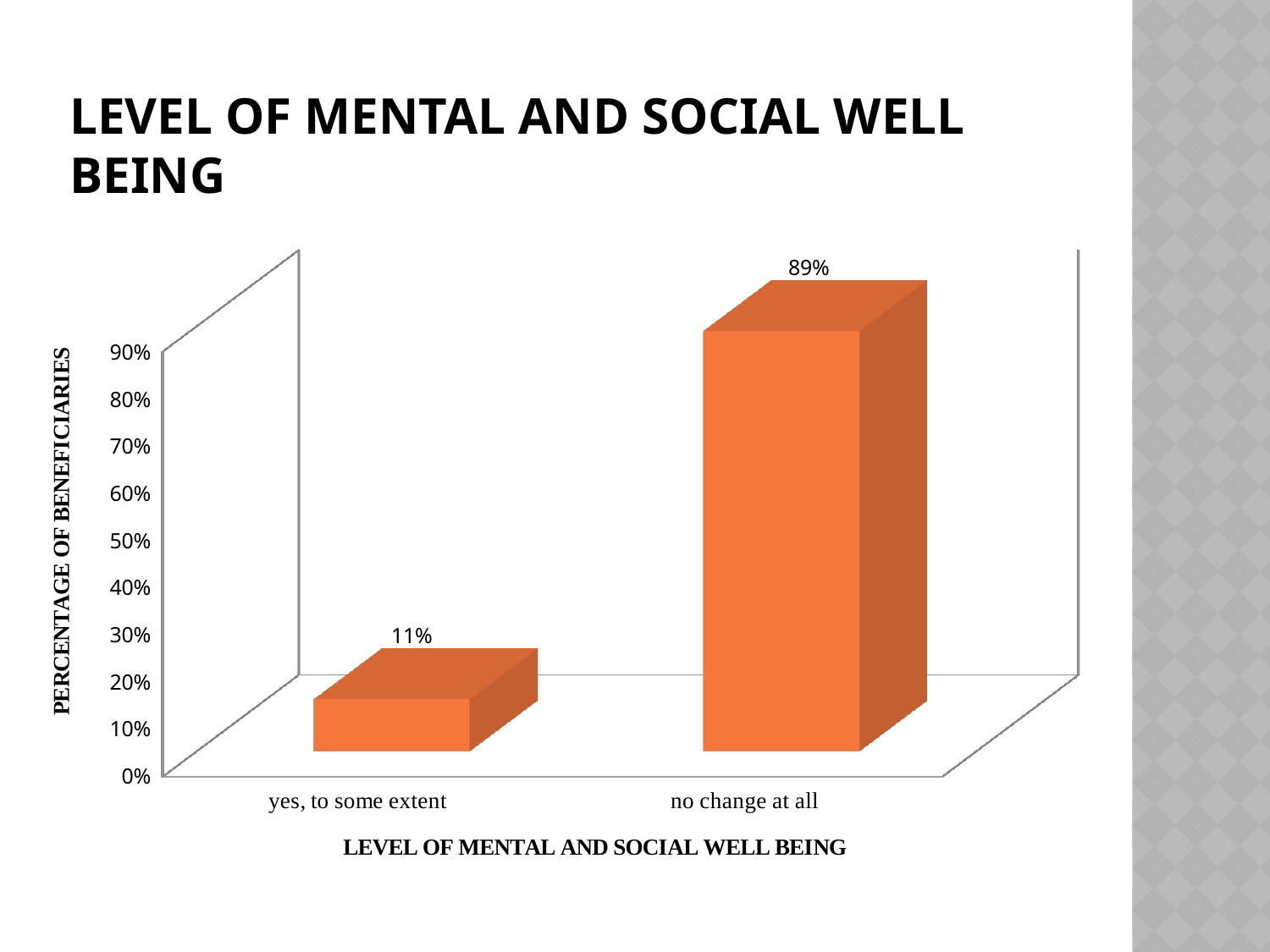
What is the value for "no change at all"? 89% What is the value for "yes, to some extent"? 11% Is the value for "yes, to some extent" greater or less than 20%? less What kind of chart is shown on the slide? bar chart What is the label of the vertical axis? PERCENTAGE OF BENEFICIARIES What is the difference between the values for "no change at all" and "yes, to some extent"? 78% Which category has the lowest value? yes, to some extent Which category has the highest value? no change at all How many categories are shown on the x axis? 2 Which is larger, the value for "yes, to some extent" or the value for "no change at all"? no change at all What is the label of the horizontal axis? LEVEL OF MENTAL AND SOCIAL WELL BEING Is the value for "no change at all" greater or less than 50%? greater